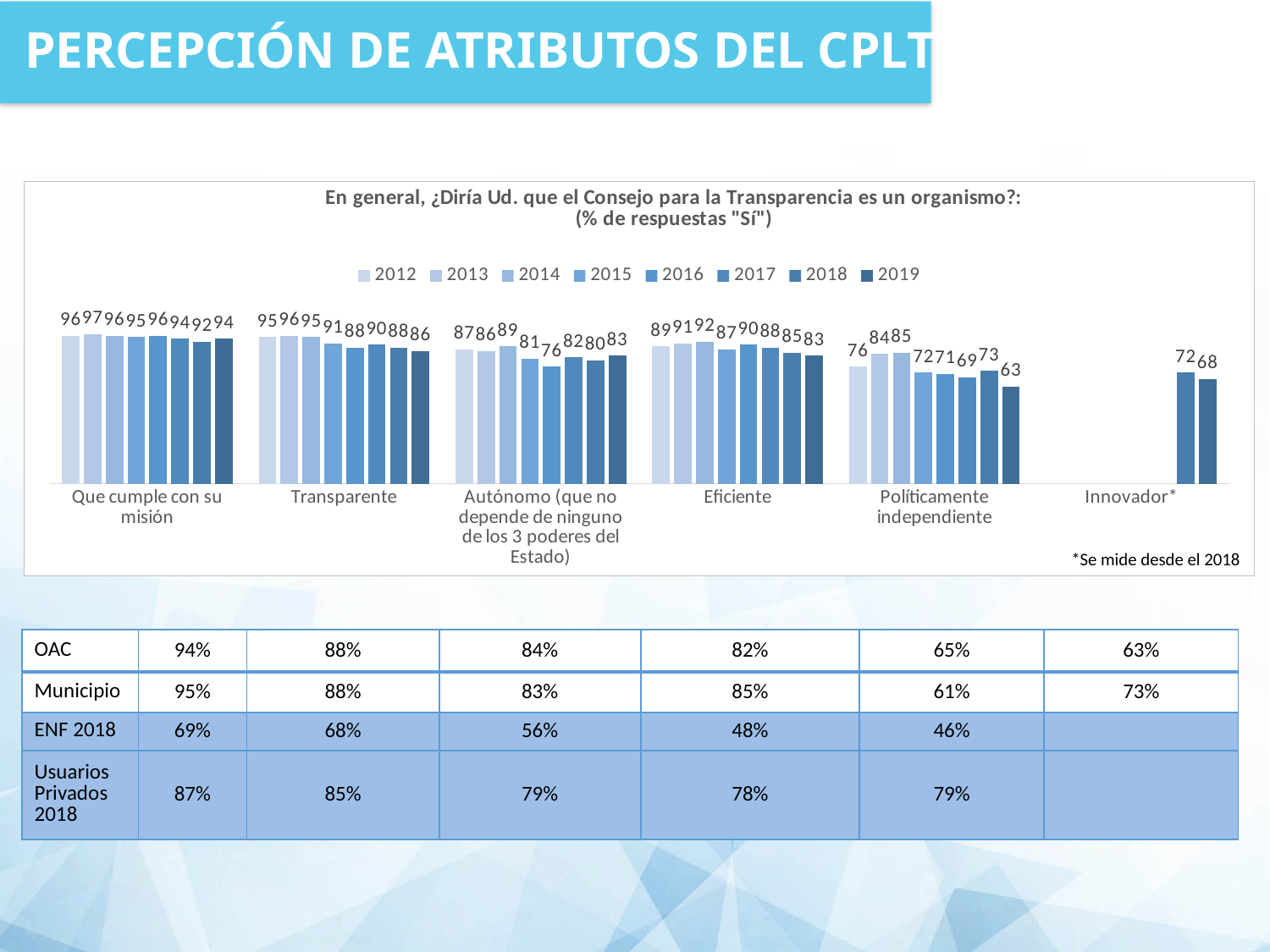
What kind of chart is shown on the slide? bar chart Which year has the lowest value for Políticamente independiente? 2019 According to the footnote, since which year has Innovador* been measured? 2018 What is the value for Transparente in 2019? 86 Which is larger in 2019: the value for Políticamente independiente or the value for Innovador*? Innovador* What is the value for Innovador* in 2019? 68 What is the value for Que cumple con su misión in 2013? 97 What is the value for Innovador* in 2018? 72 What is the difference between the 2018 and 2019 values for Innovador*? 4 What is the value for Políticamente independiente in 2019? 63 How many categories are shown along the x axis of the chart? 6 How many series does the chart legend list? 8